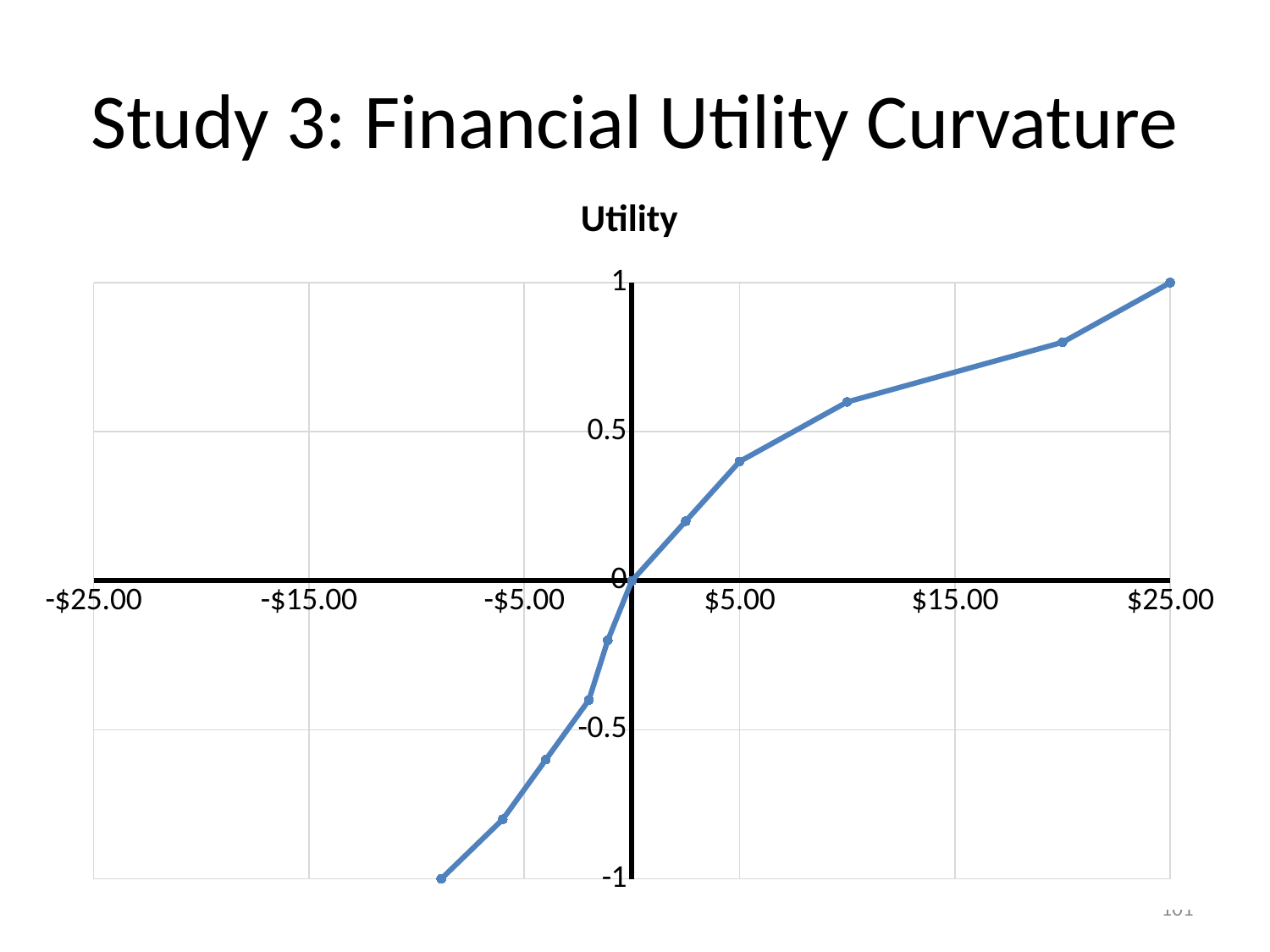
How many data points are plotted on the line? 11 What is the utility value plotted at $25.00? 1 What kind of chart is shown on the slide? line chart Is the utility value at $20.00 greater or less than 0.5? greater What is the highest utility value plotted on the chart? 1 Is the utility value at $5.00 greater or less than 0.5? less Which is larger, the utility value at $25.00 or the utility value at $5.00? $25.00 Is the utility value at $10.00 greater or less than 0.5? greater What is the lowest utility value plotted on the chart? -1 What is the largest dollar value labelled on the x axis? $25.00 What is the title of the chart? Utility Do the plotted utility values rise or fall as the dollar amount increases along the x axis? rise